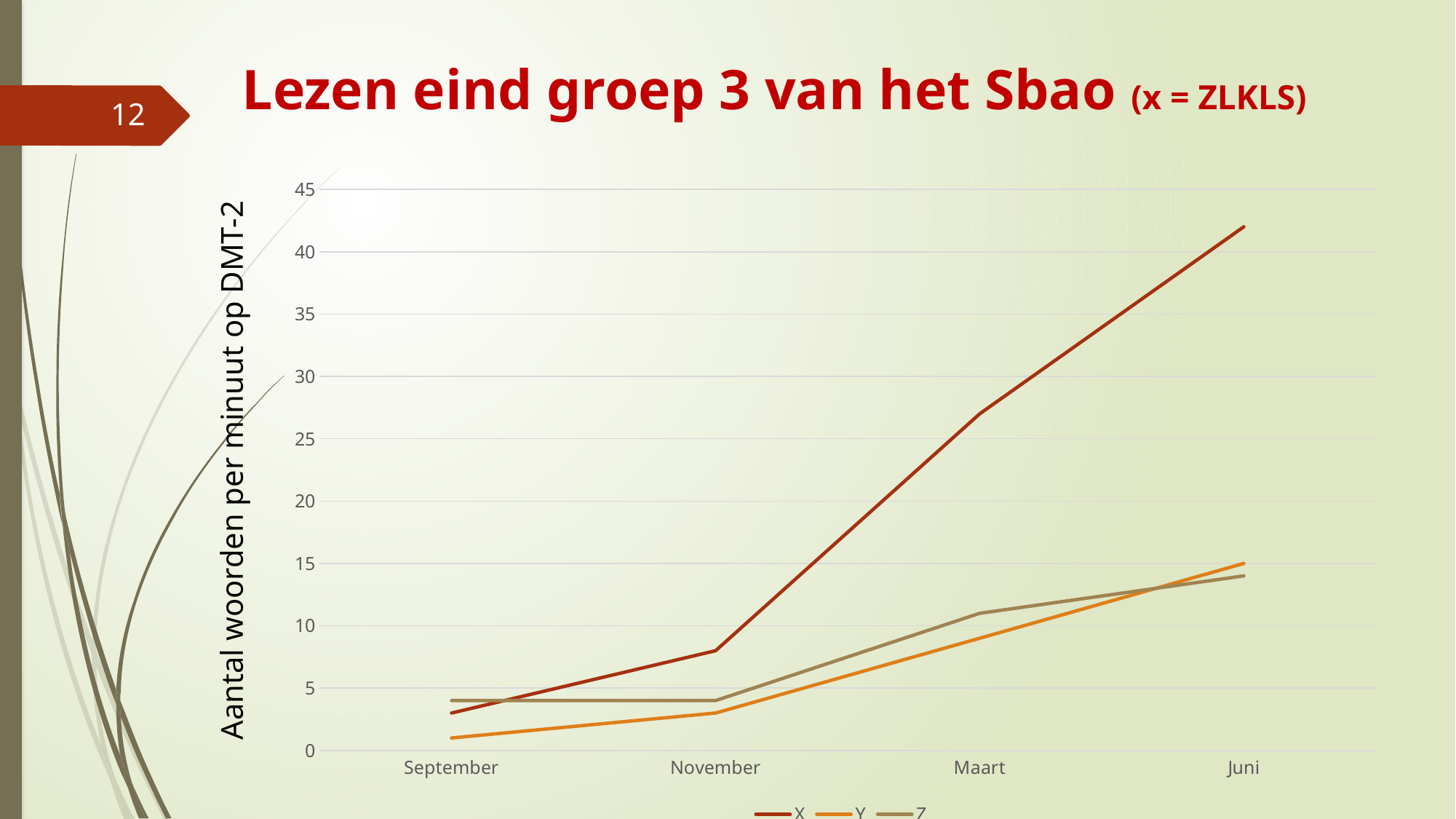
Does the value for series X rise or fall from September to Juni? rise What kind of chart is shown on the slide? line chart Which series has the lowest value in September? Y How many series does the legend list? 3 In Maart, which series has the larger value, X or Y? X Is the value for series X in Maart greater or less than 25? greater How many time points are plotted along the x axis? 4 Is the value for series Y in November greater or less than 5? less Which series has the highest value in Juni? X What is the title of the vertical axis? Aantal woorden per minuut op DMT-2 Is the value for series X in Juni greater or less than 40? greater